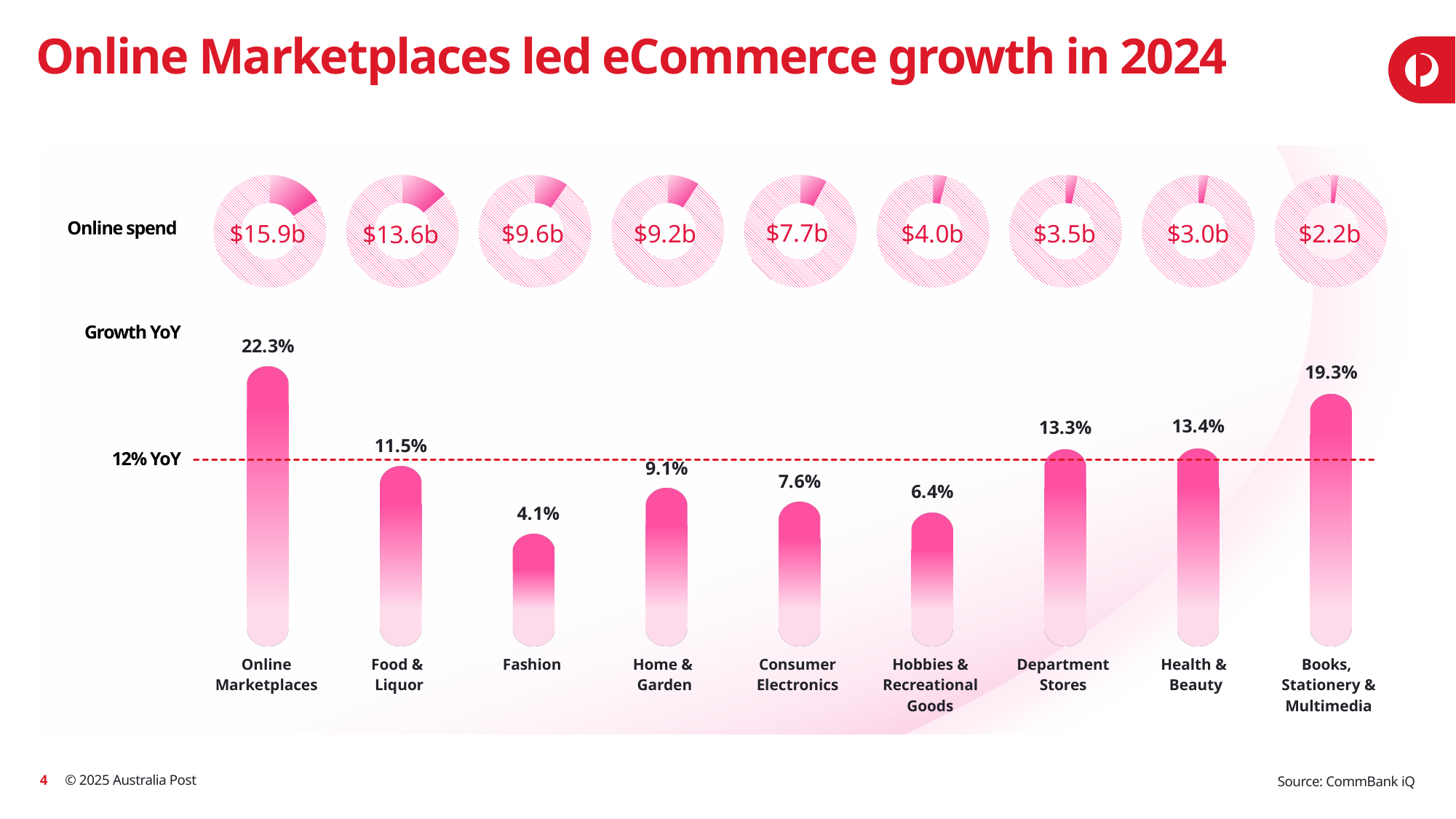
Which category has the lowest Online spend? Books, Stationery & Multimedia What kind of chart is used to show Growth YoY? Bar chart Which has a higher Growth YoY, Department Stores or Hobbies & Recreational Goods? Department Stores Which category has the lowest Growth YoY? Fashion What is the difference in Online spend between Online Marketplaces and Food & Liquor? $2.3b What Growth YoY benchmark is marked by the dashed red line? 12% YoY What is the Growth YoY value for Online Marketplaces? 22.3% What is the Online spend value for Fashion? $9.6b What is the Growth YoY value for Books, Stationery & Multimedia? 19.3% How many categories are shown in the Growth YoY bar chart? 9 Which category has the highest Growth YoY? Online Marketplaces What is the difference in Growth YoY between Online Marketplaces and Food & Liquor? 10.8%